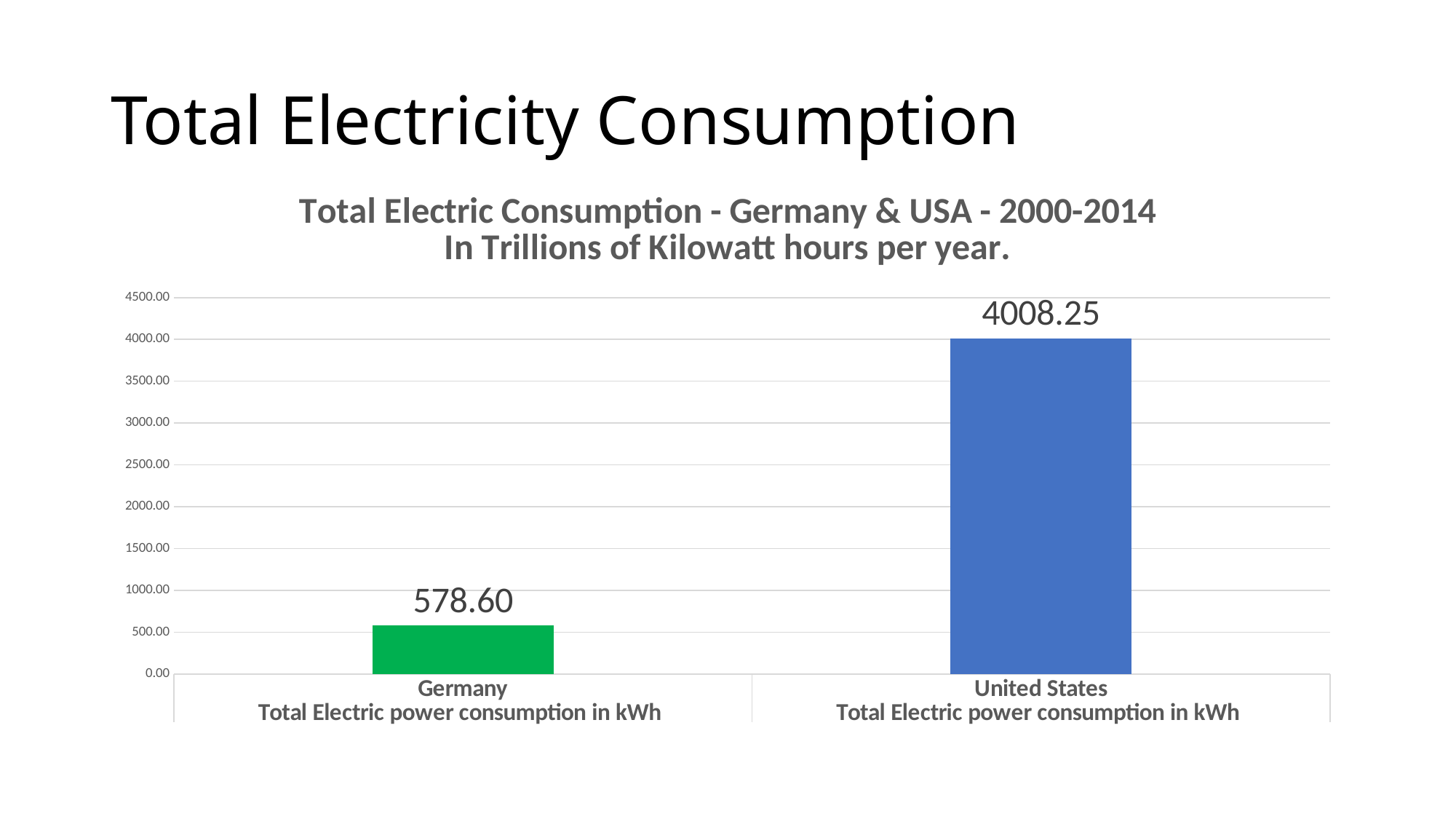
What is the difference between the United States value and the Germany value? 3429.65 Which category has the highest value? United States How many categories are plotted in the chart? 2 Which category has the lowest value? Germany What is the value shown for United States? 4008.25 What is the value shown for Germany? 578.60 Is the value for Germany greater or less than 1000.00? less What colour is the bar for Germany? green What kind of chart is shown on the slide? bar chart Which is larger, the value for Germany or the value for United States? United States Is the value for United States greater or less than 3500.00? greater What is the title of the chart? Total Electric Consumption - Germany & USA - 2000-2014 In Trillions of Kilowatt hours per year.